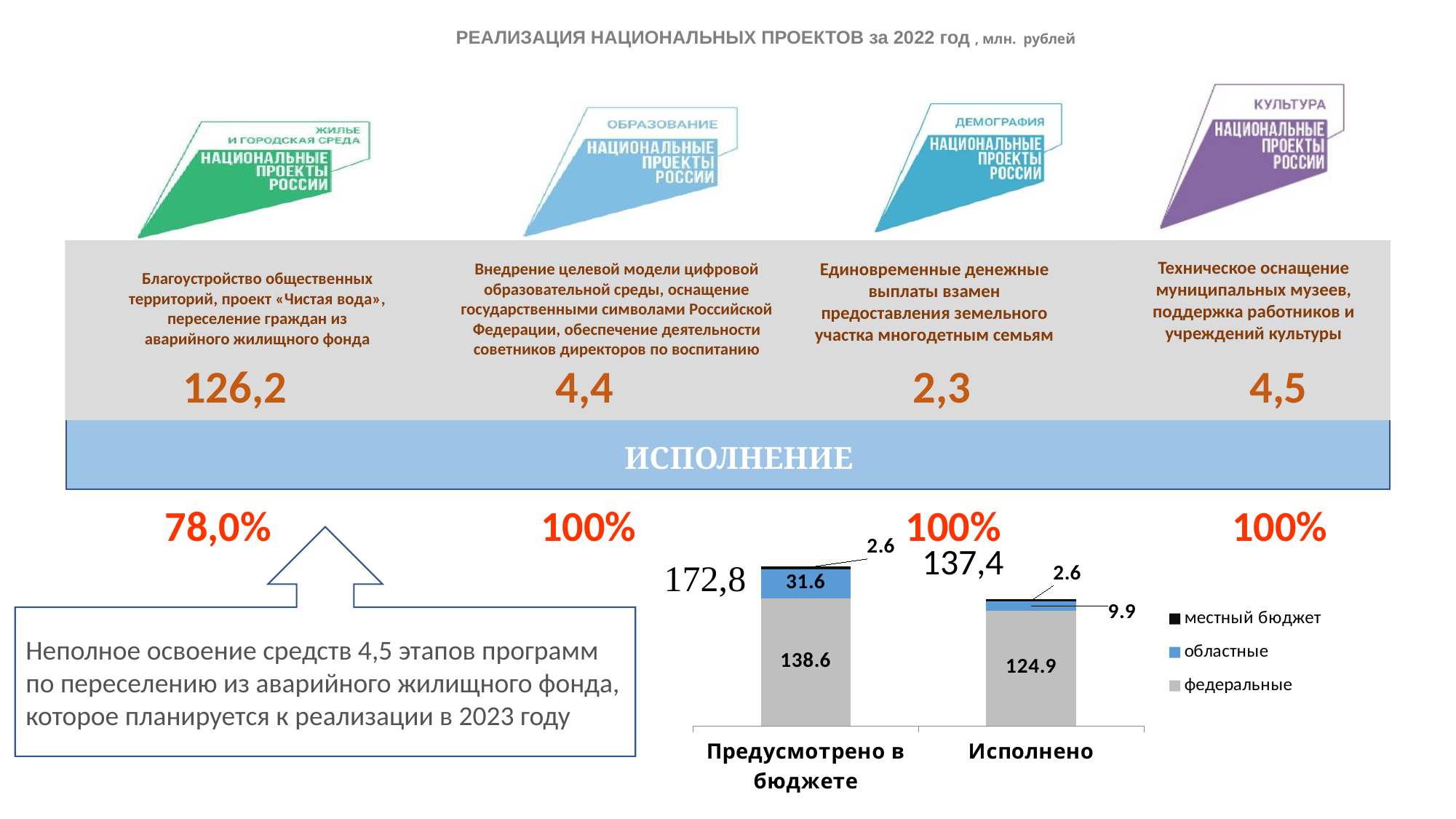
In the bar chart, which category has the larger областные value, Предусмотрено в бюджете or Исполнено? Предусмотрено в бюджете In the bar chart, which series is shown in blue? областные What kind of chart is shown at the bottom right of the slide? stacked bar chart In the bar chart, what is the total shown above the Предусмотрено в бюджете bar? 172,8 In the bar chart, what is the value of the местный бюджет segment for Предусмотрено в бюджете? 2.6 How many categories are shown on the x axis of the bar chart? 2 In the bar chart, what is the difference between the федеральные values for Предусмотрено в бюджете and Исполнено? 13.7 How many series does the legend of the bar chart list? 3 In the bar chart, what is the value of the федеральные segment for Предусмотрено в бюджете? 138.6 In the bar chart, what is the total shown above the Исполнено bar? 137,4 In the bar chart, what is the value of the областные segment for Исполнено? 9.9 In the bar chart, what is the value of the федеральные segment for Исполнено? 124.9